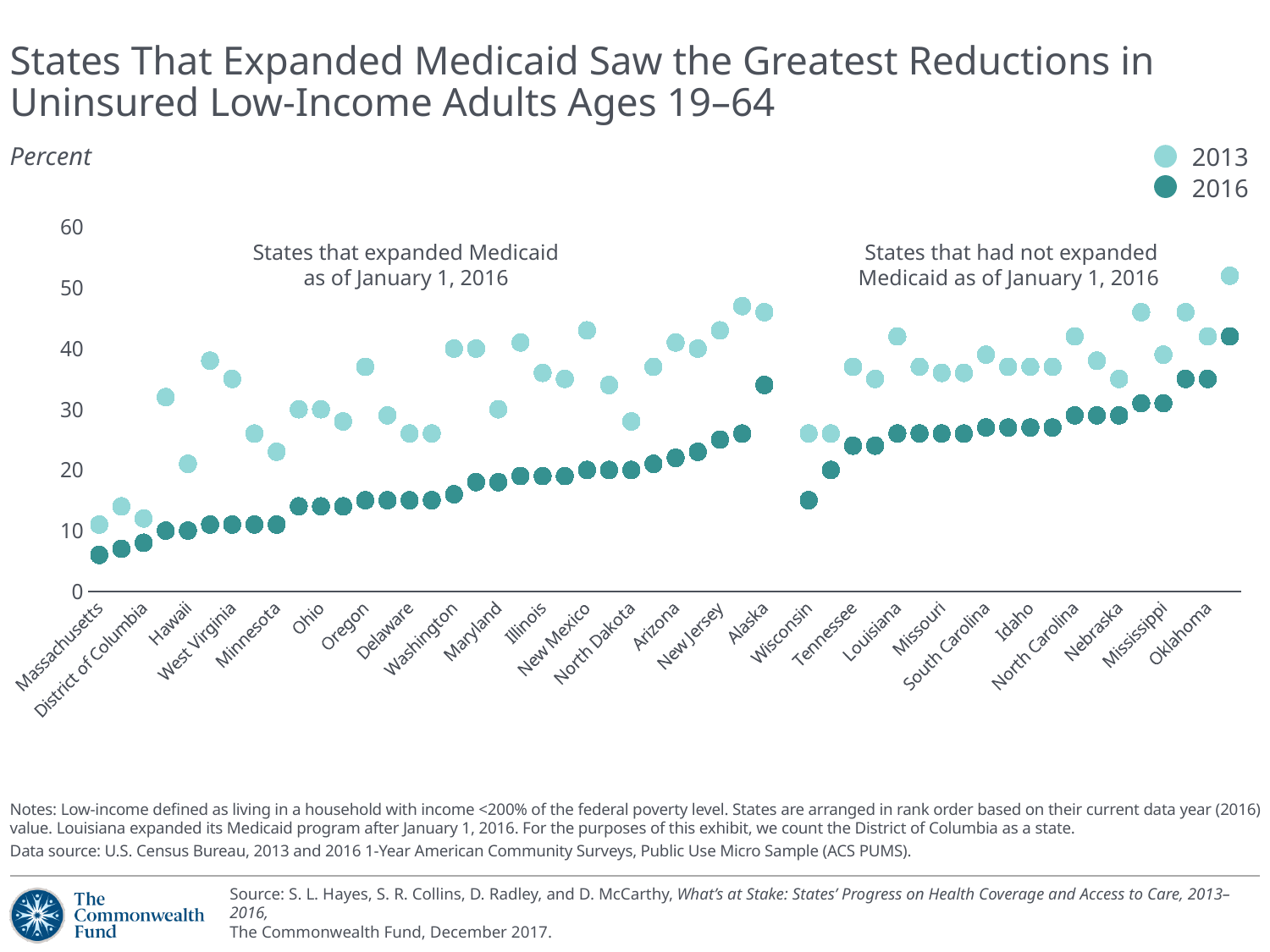
Is the 2016 value for Alaska greater or less than 30? greater How many series does the legend list? 2 Within each group of states, do the 2016 values rise or fall from left to right along the x axis? rise Is the 2016 value for Massachusetts greater or less than 10? less For Hawaii, which year has the larger value, 2013 or 2016? 2013 Is the 2013 value for Oklahoma greater or less than 40? greater Which is larger, the 2016 value for Massachusetts or the 2016 value for Oklahoma? Oklahoma Which two years are shown in the legend? 2013 and 2016 What kind of chart is shown on the slide? dot plot What is the highest tick value shown on the vertical axis? 60